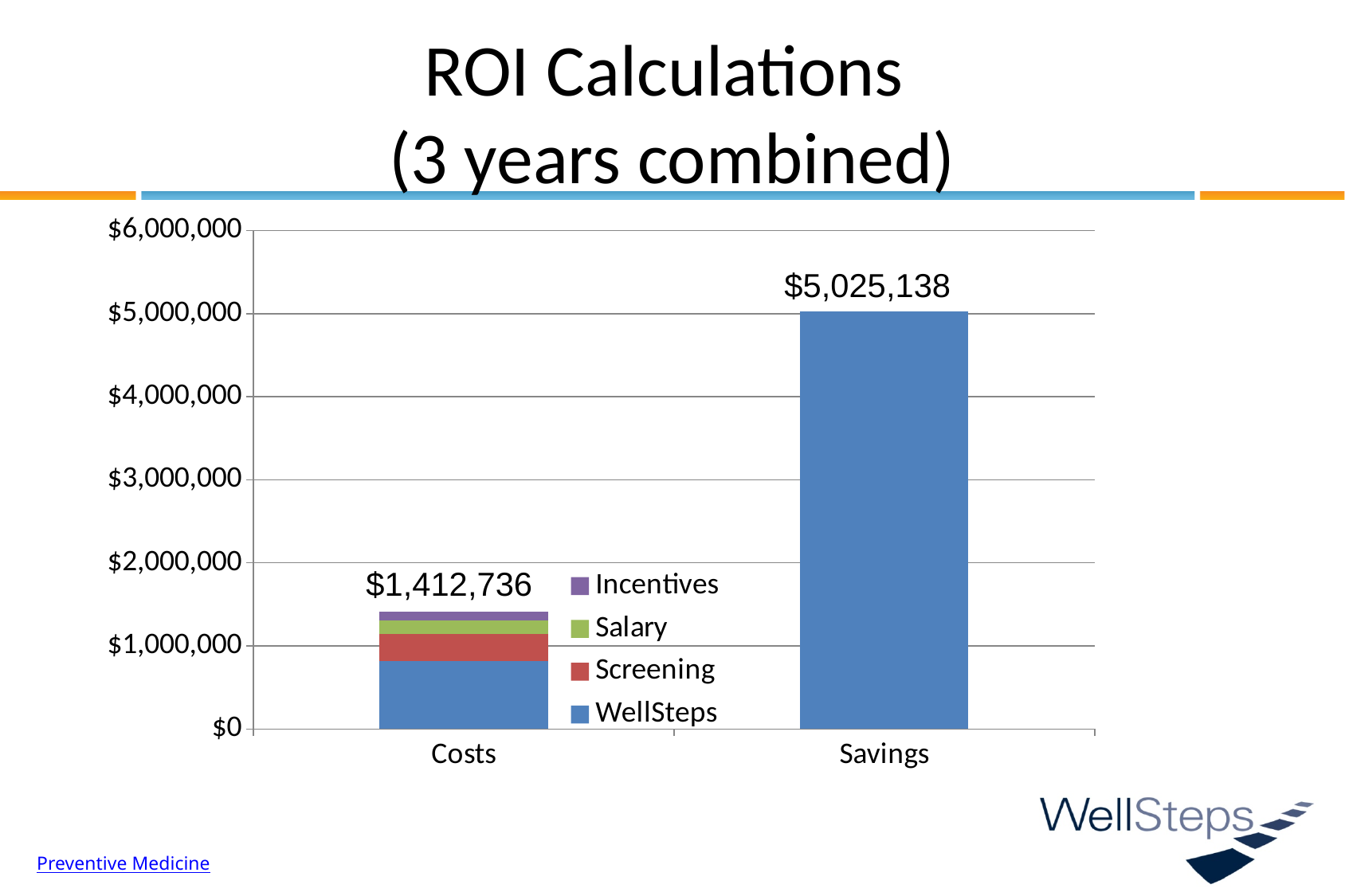
What is the title of the chart? ROI Calculations (3 years combined) How many series does the legend list? 4 Which category has the higher value, Costs or Savings? Savings Which legend entry is shown in purple? Incentives What is the value shown for Savings? $5,025,138 What kind of chart is shown on the slide? Stacked bar chart Is the WellSteps segment of the Costs bar greater or less than $1,000,000? less What is the difference between the Savings value and the total Costs value? $3,612,402 How many categories are shown on the x axis? 2 Which series is the largest segment of the Costs bar? WellSteps What is the total value shown for the Costs bar? $1,412,736 Is the Savings value greater or less than $5,000,000? greater